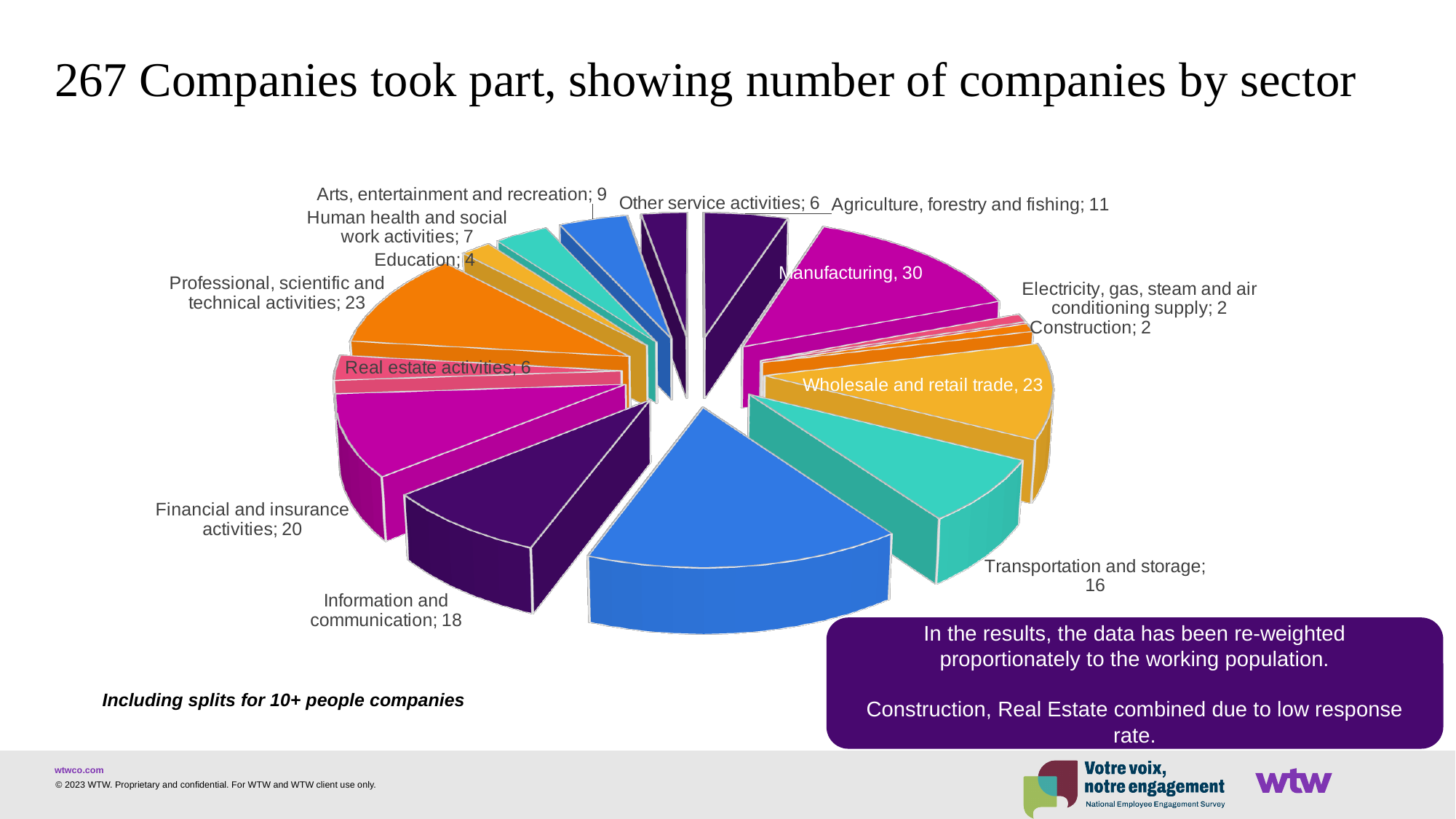
How many companies are in the Transportation and storage sector? 16 What is the title of the slide? 267 Companies took part, showing number of companies by sector Which has more companies, Information and communication or Transportation and storage? Information and communication How many companies are in the Agriculture, forestry and fishing sector? 11 How many companies are in the Education sector? 4 How many companies are in the Manufacturing sector? 30 How many sectors are shown in the pie chart? 15 What is the difference between the number of companies in Manufacturing and in Wholesale and retail trade? 7 What is the difference between the number of companies in Financial and insurance activities and in Information and communication? 2 How many companies are in the Financial and insurance activities sector? 20 What type of chart is shown on the slide? pie chart